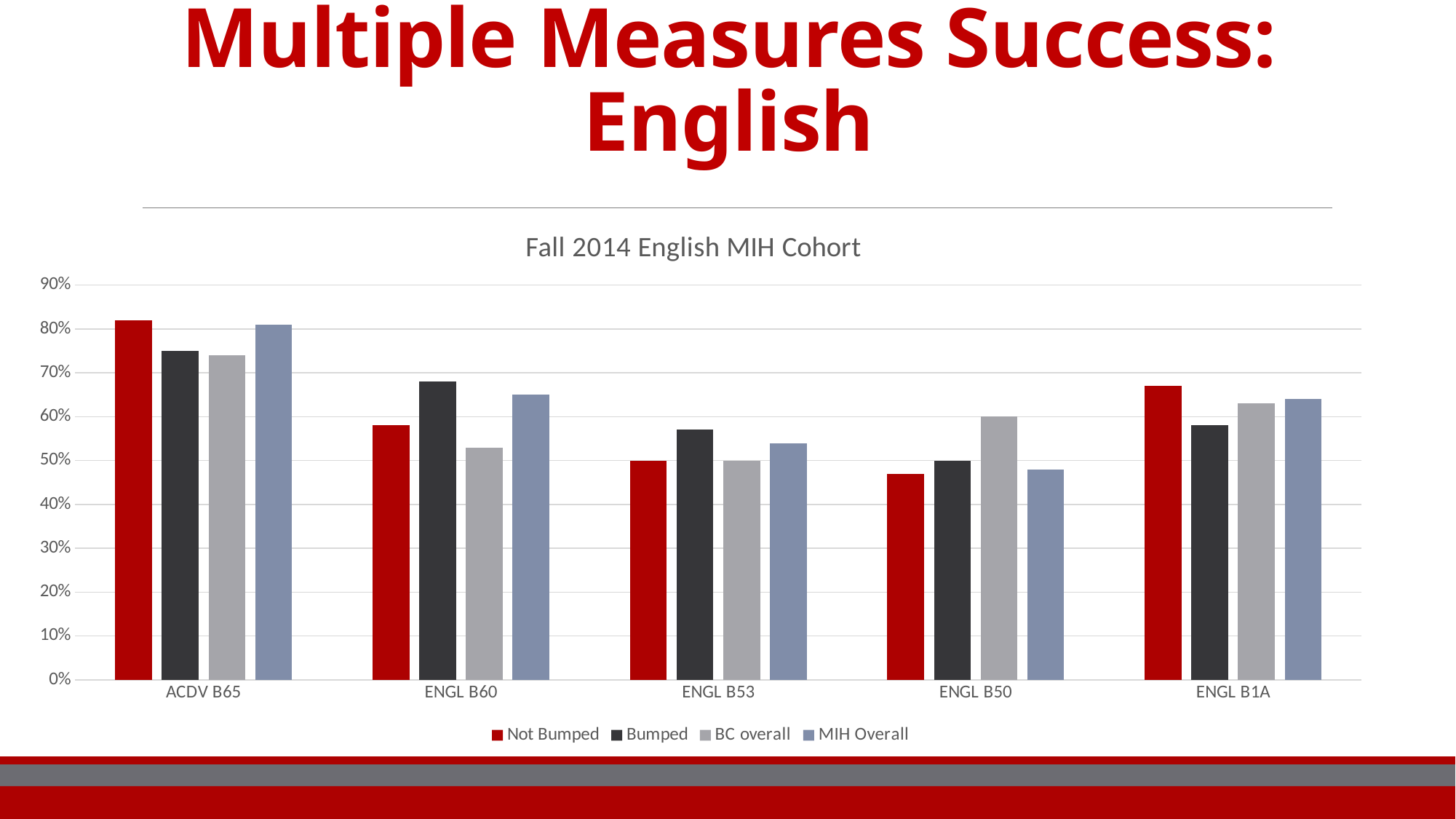
For ENGL B1A, which is larger: the Not Bumped value or the Bumped value? Not Bumped How many course categories are shown on the x axis of the chart? 5 How many series does the chart's legend list? 4 For ENGL B60, which is larger: the Bumped value or the Not Bumped value? Bumped Is the Not Bumped value for ACDV B65 greater or less than 70%? greater Which course has the lowest Bumped value? ENGL B50 What is the title of the chart? Fall 2014 English MIH Cohort What kind of chart is shown on the slide? bar chart Is the BC overall value for ENGL B60 greater or less than 60%? less Which course has the highest Not Bumped value? ACDV B65 Which series has the highest value for ENGL B50? BC overall Is the BC overall value for ENGL B50 greater or less than 50%? greater